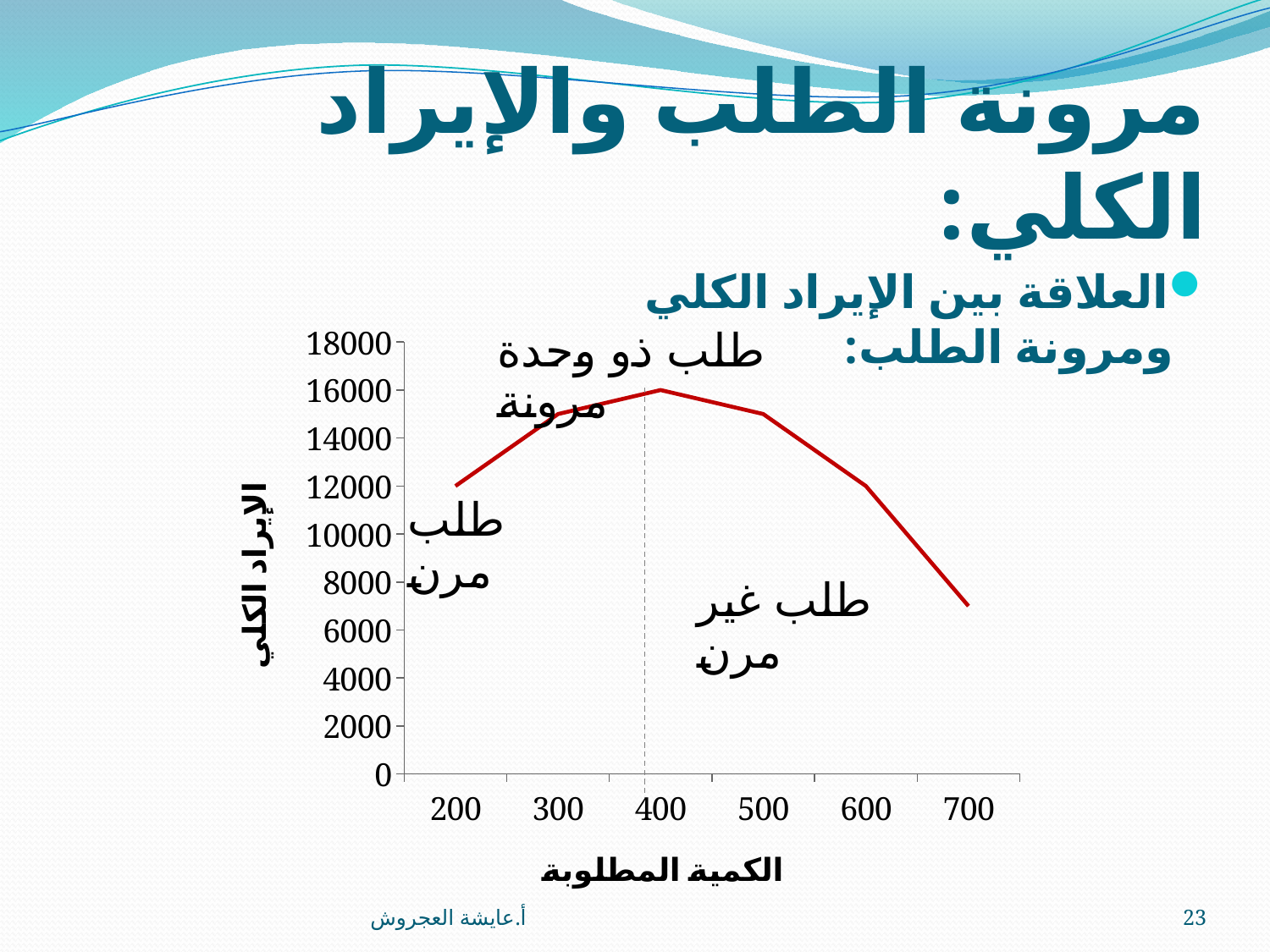
What is the total revenue at a quantity demanded of 400? 16000 What kind of chart is shown on the slide? line chart At which quantity demanded (x-axis value) is total revenue lowest? 700 Is the total revenue at a quantity of 500 greater or less than 14000? greater What is the title of the x-axis? الكمية المطلوبة How many data points are plotted on the line? 6 At which quantity demanded (x-axis value) does total revenue reach its highest point? 400 Is the total revenue at a quantity of 300 greater or less than 14000? greater Is the total revenue at a quantity of 700 greater or less than 8000? less What is the total revenue at a quantity demanded of 200? 12000 Which has the higher total revenue: a quantity of 200 or a quantity of 700? 200 How does total revenue change as quantity demanded increases from 400 to 700? it falls